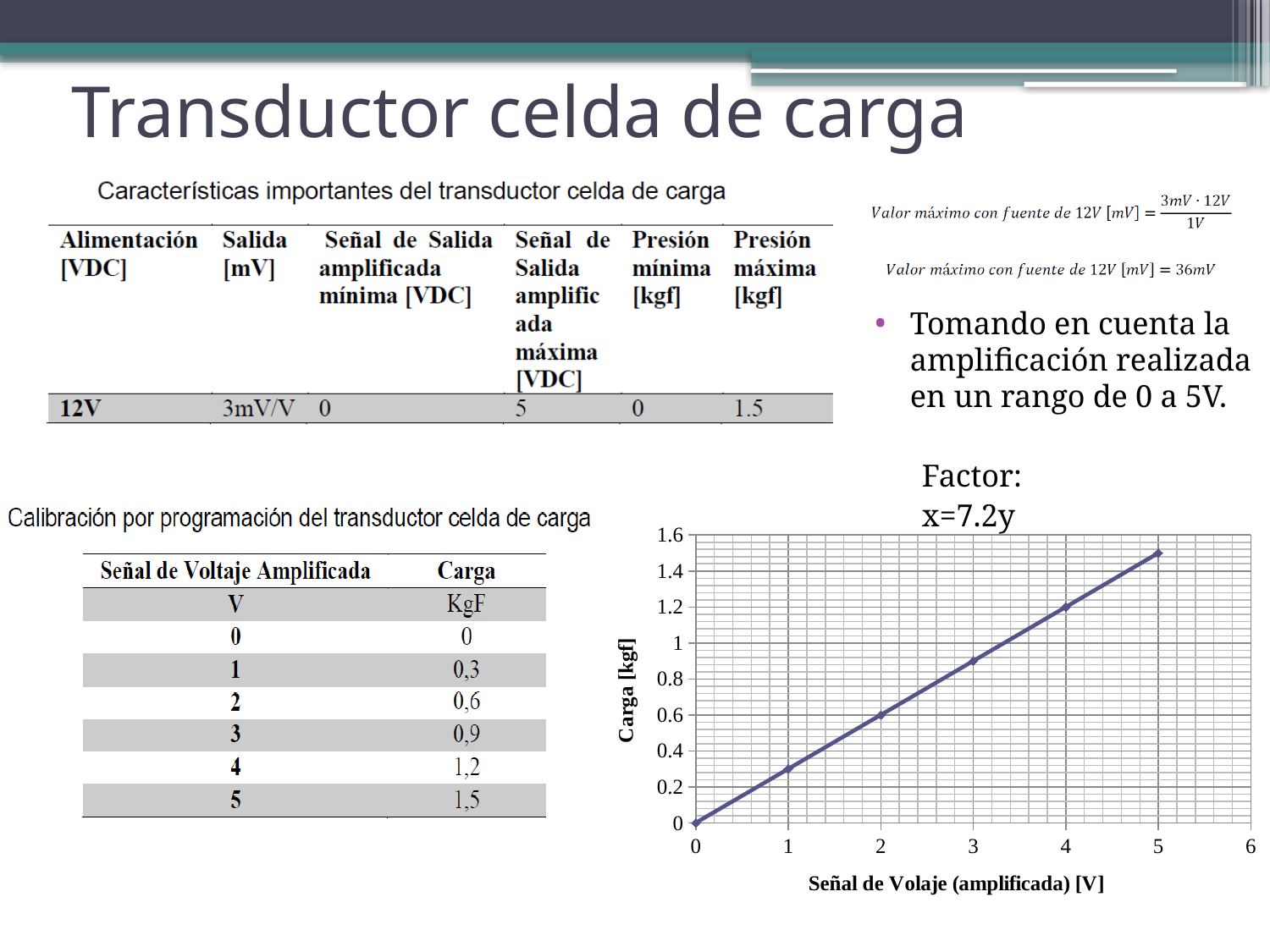
What is the Carga value at a Señal de Voltaje of 0 V? 0 Does the Carga value rise or fall as the voltage increases along the x axis? rise What is the Carga value at a Señal de Voltaje of 4 V? 1.2 At which voltage is the Carga value highest? 5 Is the Carga value at 3 V greater or less than 1? less What is the Carga value at a Señal de Voltaje of 2 V? 0.6 What kind of chart is shown on the slide? line chart Is the Carga value at 5 V greater or less than 1.4? greater What is the title of the y axis of the chart? Carga [kgf] Is the Carga value at 1 V greater or less than 0.4? less What is the difference between the Carga values at 4 V and 2 V? 0.6 How many data points are plotted on the line chart? 6